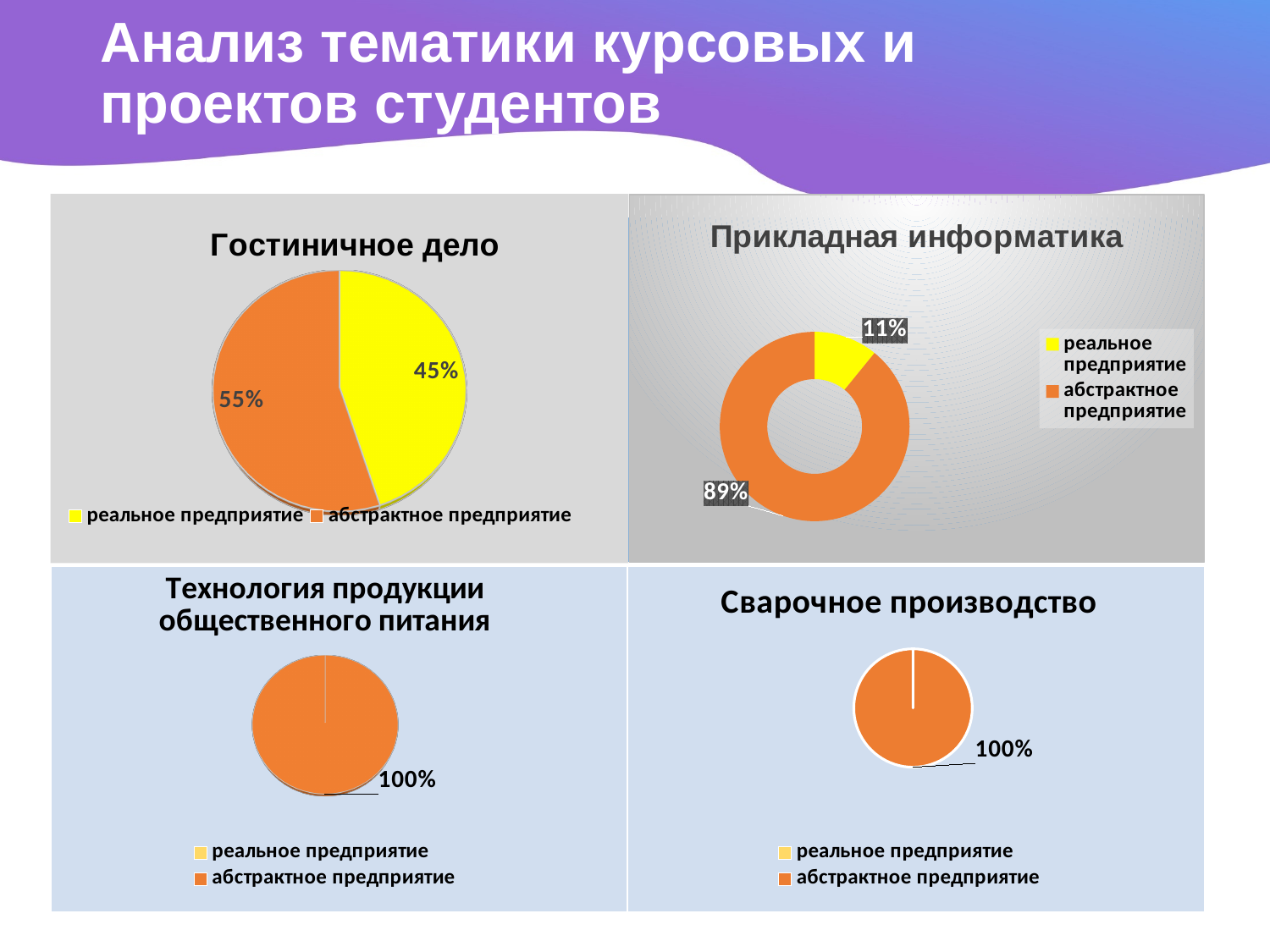
In the 'Гостиничное дело' chart, what is the difference between the 'абстрактное предприятие' and 'реальное предприятие' shares? 10% In the 'Сварочное производство' chart, what share is labelled for 'абстрактное предприятие'? 100% In the 'Прикладная информатика' chart, what share is labelled for 'абстрактное предприятие'? 89% What kind of chart is the 'Прикладная информатика' chart? doughnut chart In the 'Прикладная информатика' chart, what share is labelled for 'реальное предприятие'? 11% In the 'Гостиничное дело' chart, what share is labelled for 'реальное предприятие'? 45% In the 'Технология продукции общественного питания' chart, what share is labelled for 'абстрактное предприятие'? 100% In the 'Гостиничное дело' chart, which category has the larger slice? абстрактное предприятие How many entries does the legend of the 'Сварочное производство' chart list? 2 In the 'Гостиничное дело' chart, what share is labelled for 'абстрактное предприятие'? 55% In the 'Прикладная информатика' chart, which category has the smaller slice? реальное предприятие What kind of chart is the 'Гостиничное дело' chart? pie chart